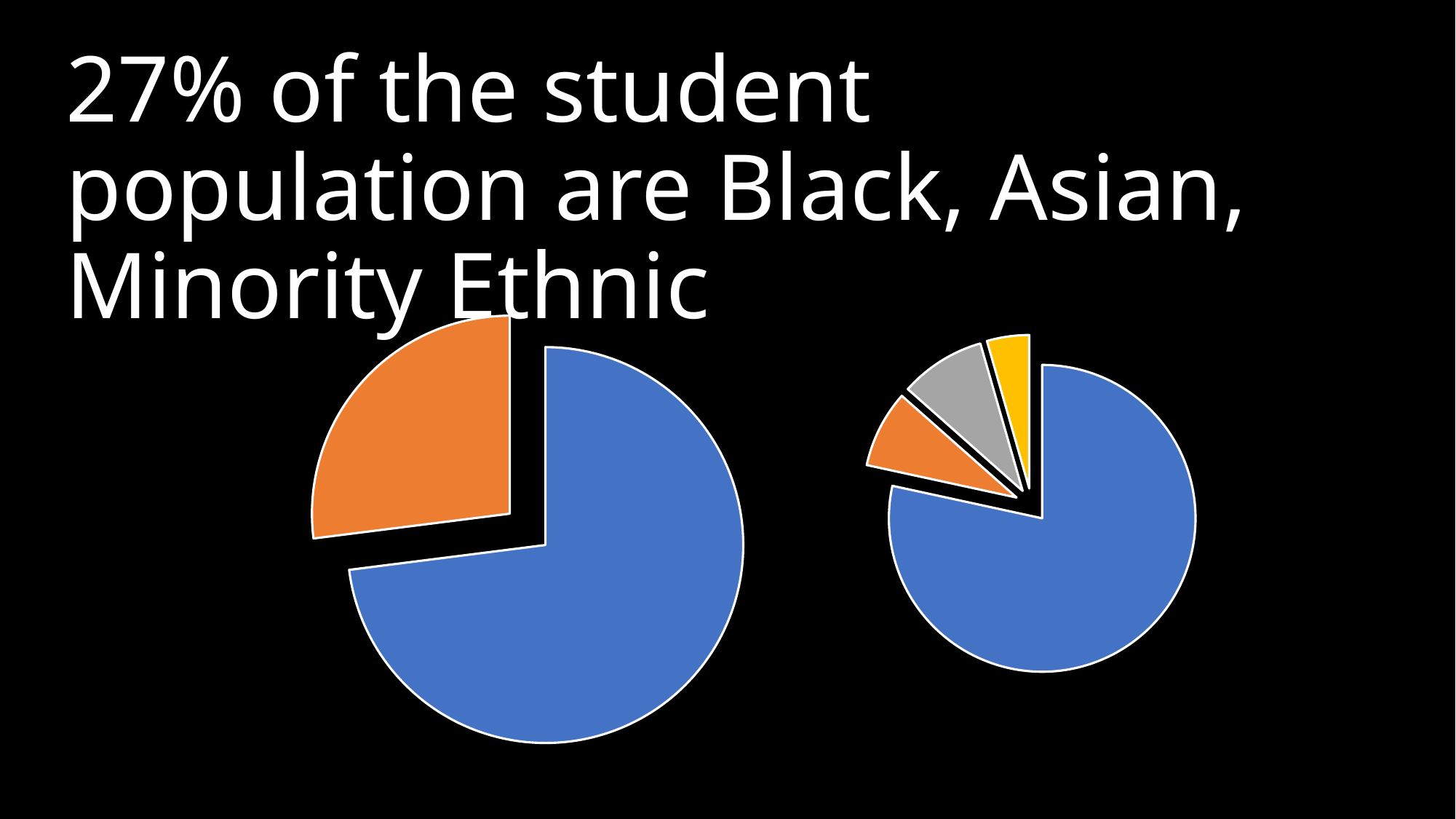
In the pie chart on the right of the slide, which colour slice is the largest? blue How many slices does the pie chart on the right of the slide have? 4 In the pie chart on the left of the slide, which is larger, the blue slice or the orange slice? blue How many pie charts are shown on the slide? 2 What percentage of the student population does the slide's heading say are Black, Asian, Minority Ethnic? 27% In the pie chart on the right of the slide, which colour slice is the smallest? yellow What kind of chart is the chart on the right of the slide? pie chart How many slices does the pie chart on the left of the slide have? 2 What kind of chart is the chart on the left of the slide? pie chart In the pie chart on the left of the slide, which colour slice is the largest? blue In the pie chart on the right of the slide, which is larger, the blue slice or the yellow slice? blue